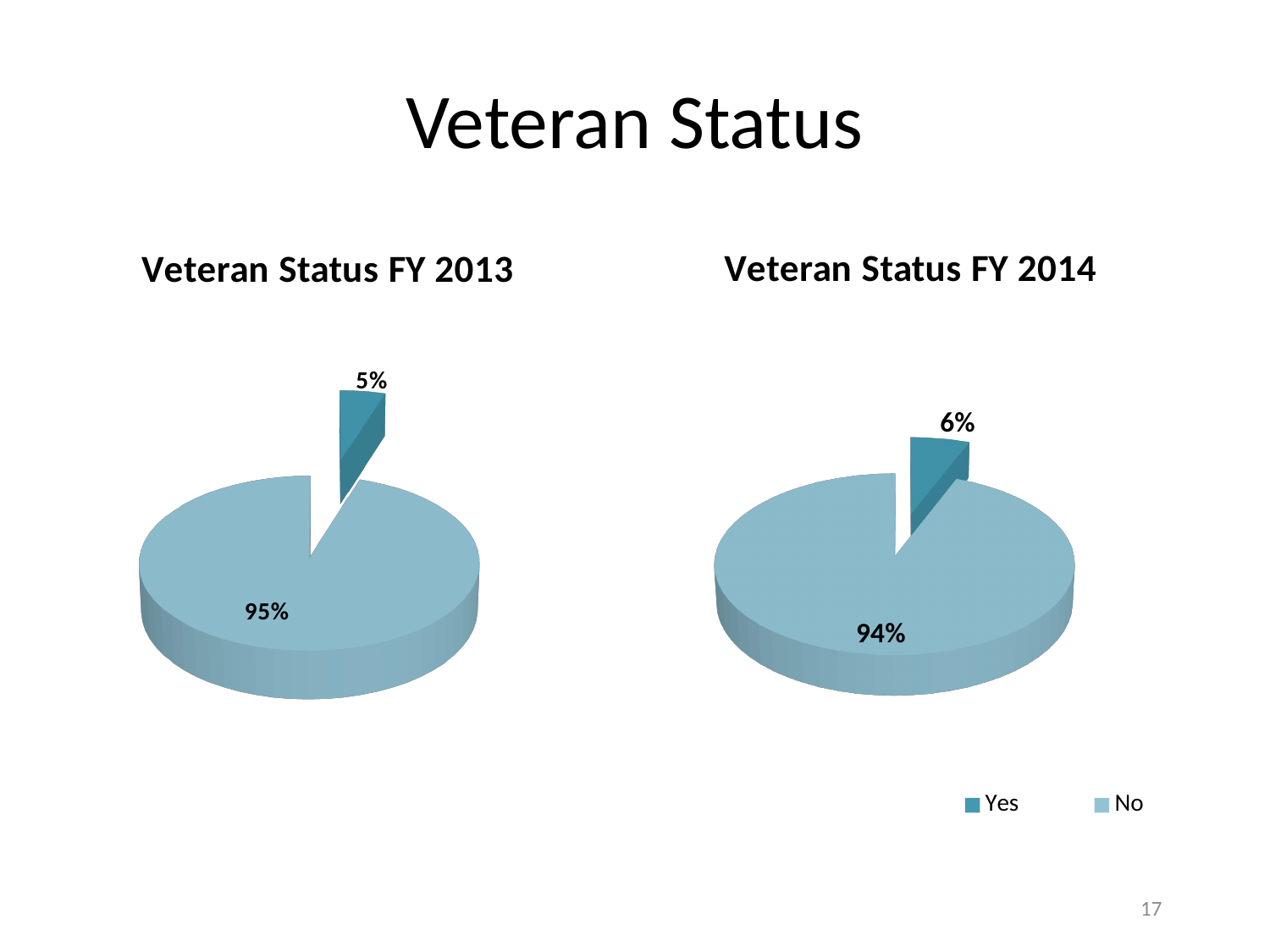
In the Veteran Status FY 2013 chart, what percentage is shown for No? 95% In the Veteran Status FY 2014 chart, which category has the smallest slice? Yes What is the title of the chart on the right side of the slide? Veteran Status FY 2014 What type of chart is the Veteran Status FY 2013 chart? Pie chart Is the Yes percentage larger in the Veteran Status FY 2013 chart or the Veteran Status FY 2014 chart? Veteran Status FY 2014 In the Veteran Status FY 2014 chart, what percentage is shown for Yes? 6% How many entries does the legend list? 2 In the Veteran Status FY 2014 chart, what is the difference between the No and Yes percentages? 88% In the Veteran Status FY 2013 chart, what percentage is shown for Yes? 5% In the Veteran Status FY 2014 chart, what percentage is shown for No? 94% In the Veteran Status FY 2013 chart, which category has the largest slice? No How many slices does the Veteran Status FY 2014 chart have? 2